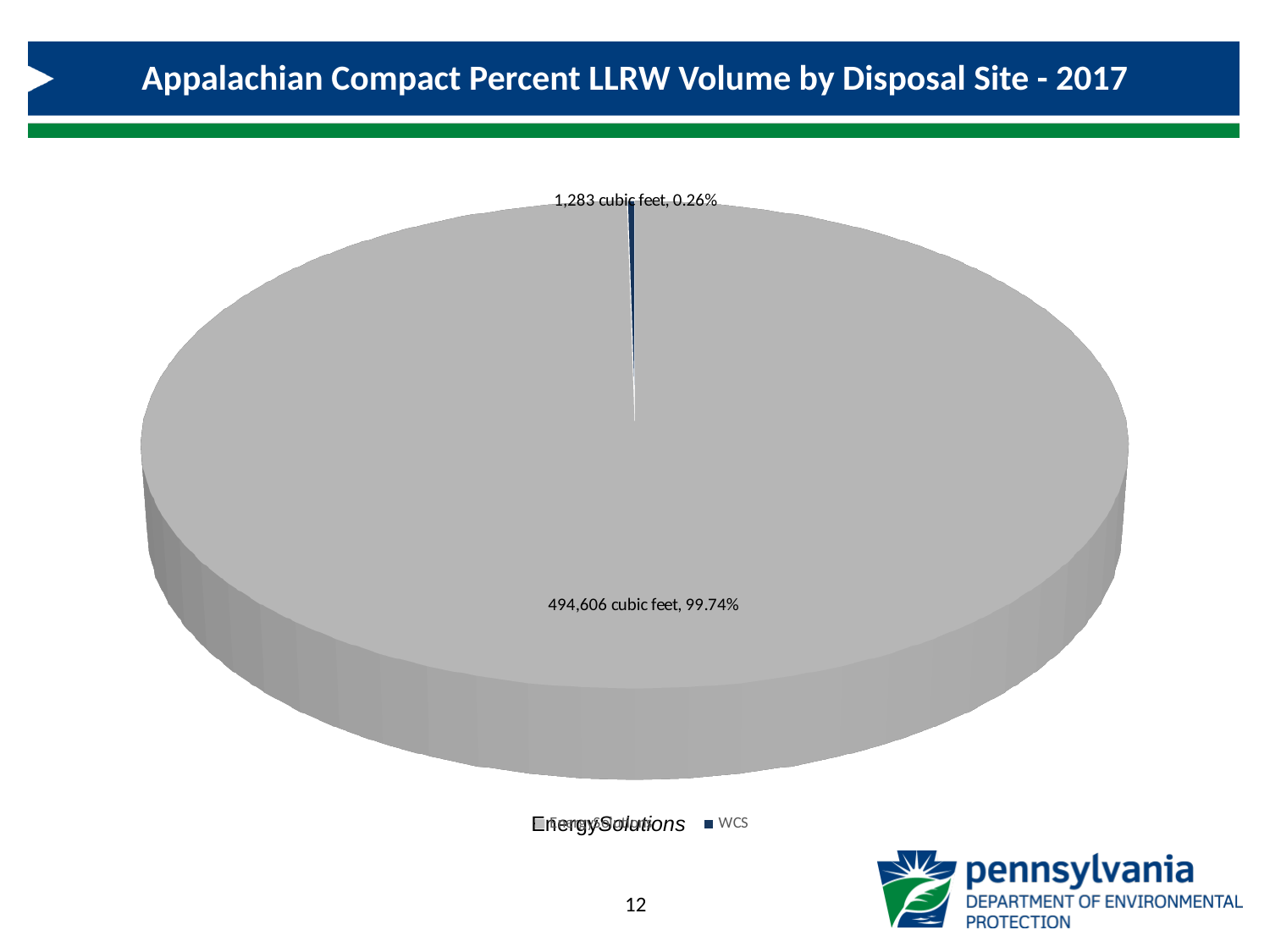
How many slices does the pie chart have? 2 What kind of chart is shown on the slide? pie chart What share of the pie does the WCS slice represent? 0.26% Which disposal site has the smallest share of the pie? WCS Which disposal site has the largest share of the pie? EnergySolutions What is the title of the chart? Appalachian Compact Percent LLRW Volume by Disposal Site - 2017 What share of the pie does the EnergySolutions slice represent? 99.74% What volume in cubic feet is labelled for the EnergySolutions slice? 494,606 cubic feet What is the difference in percentage points between the EnergySolutions share and the WCS share? 99.48 What volume in cubic feet is labelled for the WCS slice? 1,283 cubic feet How many entries does the legend list? 2 Which is larger, the volume for EnergySolutions or the volume for WCS? EnergySolutions